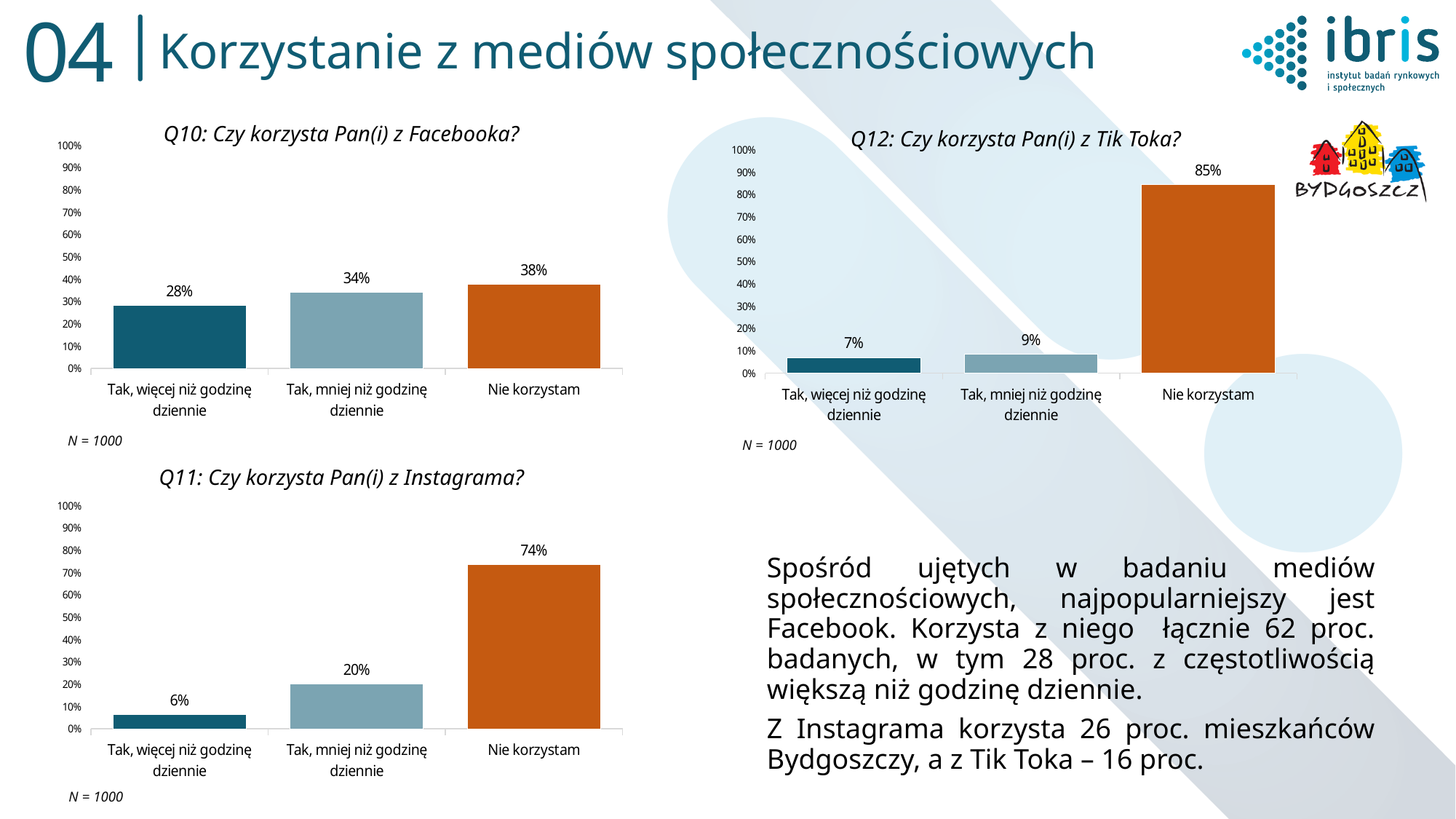
In the chart 'Q11: Czy korzysta Pan(i) z Instagrama?', what is the value for 'Tak, mniej niż godzinę dziennie'? 20% In the chart 'Q10: Czy korzysta Pan(i) z Facebooka?', what is the value for 'Tak, więcej niż godzinę dziennie'? 28% In the chart 'Q10: Czy korzysta Pan(i) z Facebooka?', what is the difference between 'Tak, mniej niż godzinę dziennie' and 'Tak, więcej niż godzinę dziennie'? 6% In the chart 'Q12: Czy korzysta Pan(i) z Tik Toka?', which category has the lowest value? Tak, więcej niż godzinę dziennie In the chart 'Q12: Czy korzysta Pan(i) z Tik Toka?', which is larger: 'Tak, więcej niż godzinę dziennie' or 'Tak, mniej niż godzinę dziennie'? Tak, mniej niż godzinę dziennie In the chart 'Q11: Czy korzysta Pan(i) z Instagrama?', do the values rise or fall from left to right? Rise In the chart 'Q11: Czy korzysta Pan(i) z Instagrama?', what is the difference between 'Nie korzystam' and 'Tak, więcej niż godzinę dziennie'? 68% How many categories are shown in the chart 'Q11: Czy korzysta Pan(i) z Instagrama?'? 3 In the chart 'Q10: Czy korzysta Pan(i) z Facebooka?', which category has the highest value? Nie korzystam In the chart 'Q10: Czy korzysta Pan(i) z Facebooka?', what is the value for 'Nie korzystam'? 38% In the chart 'Q12: Czy korzysta Pan(i) z Tik Toka?', what is the value for 'Nie korzystam'? 85% What kind of chart is 'Q12: Czy korzysta Pan(i) z Tik Toka?'? Bar chart